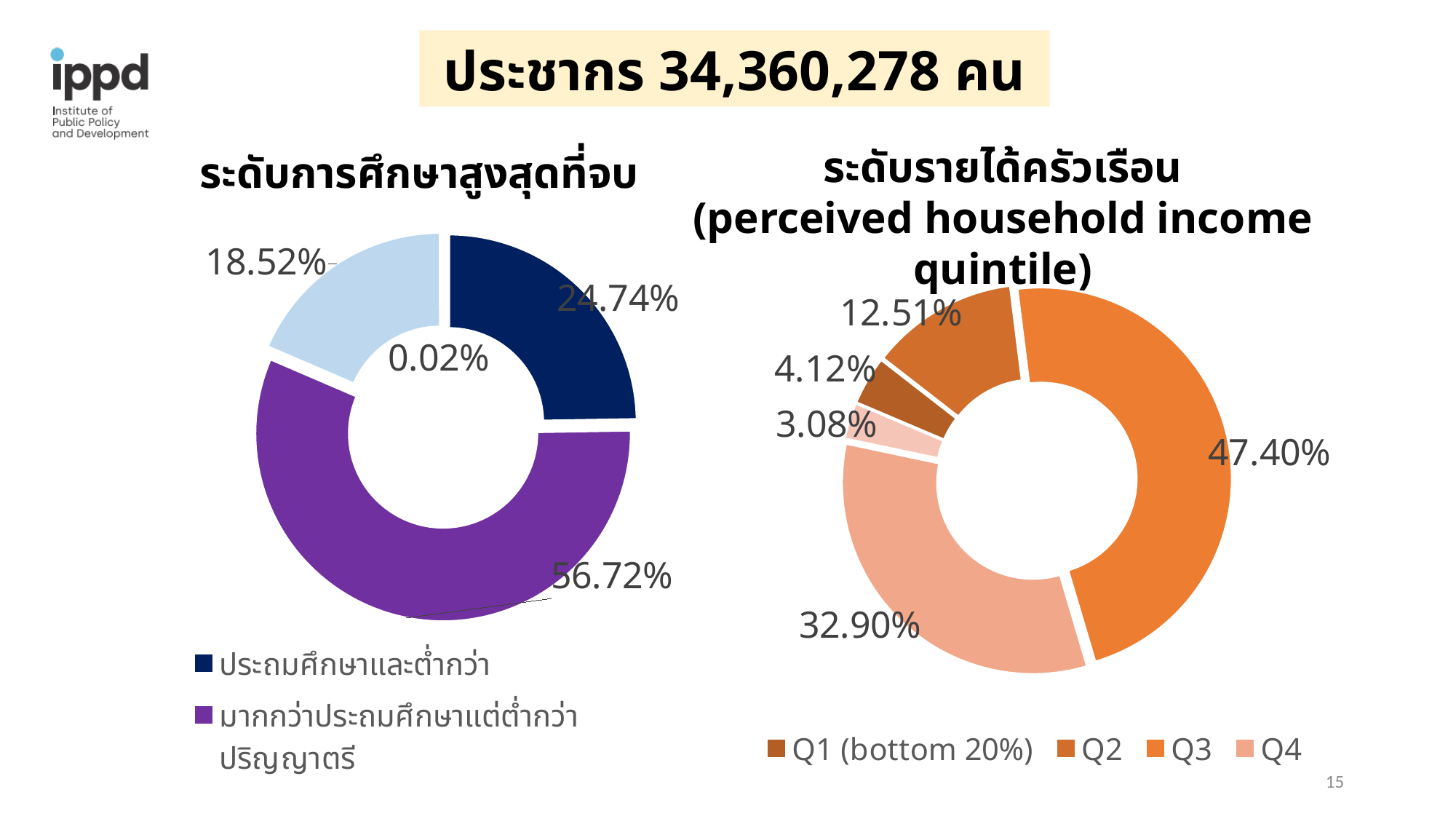
In the right chart (ระดับรายได้ครัวเรือน), what is the value for Q4? 32.90% How many entries does the legend of the right chart (ระดับรายได้ครัวเรือน) list? 4 In the left chart (ระดับการศึกษาสูงสุดที่จบ), what is the value for ประถมศึกษาและต่ำกว่า? 24.74% In the right chart (ระดับรายได้ครัวเรือน), what is the value for Q3? 47.40% In the left chart (ระดับการศึกษาสูงสุดที่จบ), what is the value of the smallest slice? 0.02% In the right chart (ระดับรายได้ครัวเรือน), what is the difference between the values for Q3 and Q4? 14.50 percentage points In the left chart (ระดับการศึกษาสูงสุดที่จบ), what is the value of the largest slice? 56.72% In the left chart (ระดับการศึกษาสูงสุดที่จบ), what is the difference between the values for มากกว่าประถมศึกษาแต่ต่ำกว่าปริญญาตรี and ประถมศึกษาและต่ำกว่า? 31.98 percentage points What kind of chart is the left chart (ระดับการศึกษาสูงสุดที่จบ)? Doughnut chart In the right chart (ระดับรายได้ครัวเรือน), which is larger, Q2 or Q1 (bottom 20%)? Q2 In the right chart (ระดับรายได้ครัวเรือน), what is the value for Q1 (bottom 20%)? 4.12% In the left chart (ระดับการศึกษาสูงสุดที่จบ), what is the value for มากกว่าประถมศึกษาแต่ต่ำกว่าปริญญาตรี? 56.72%